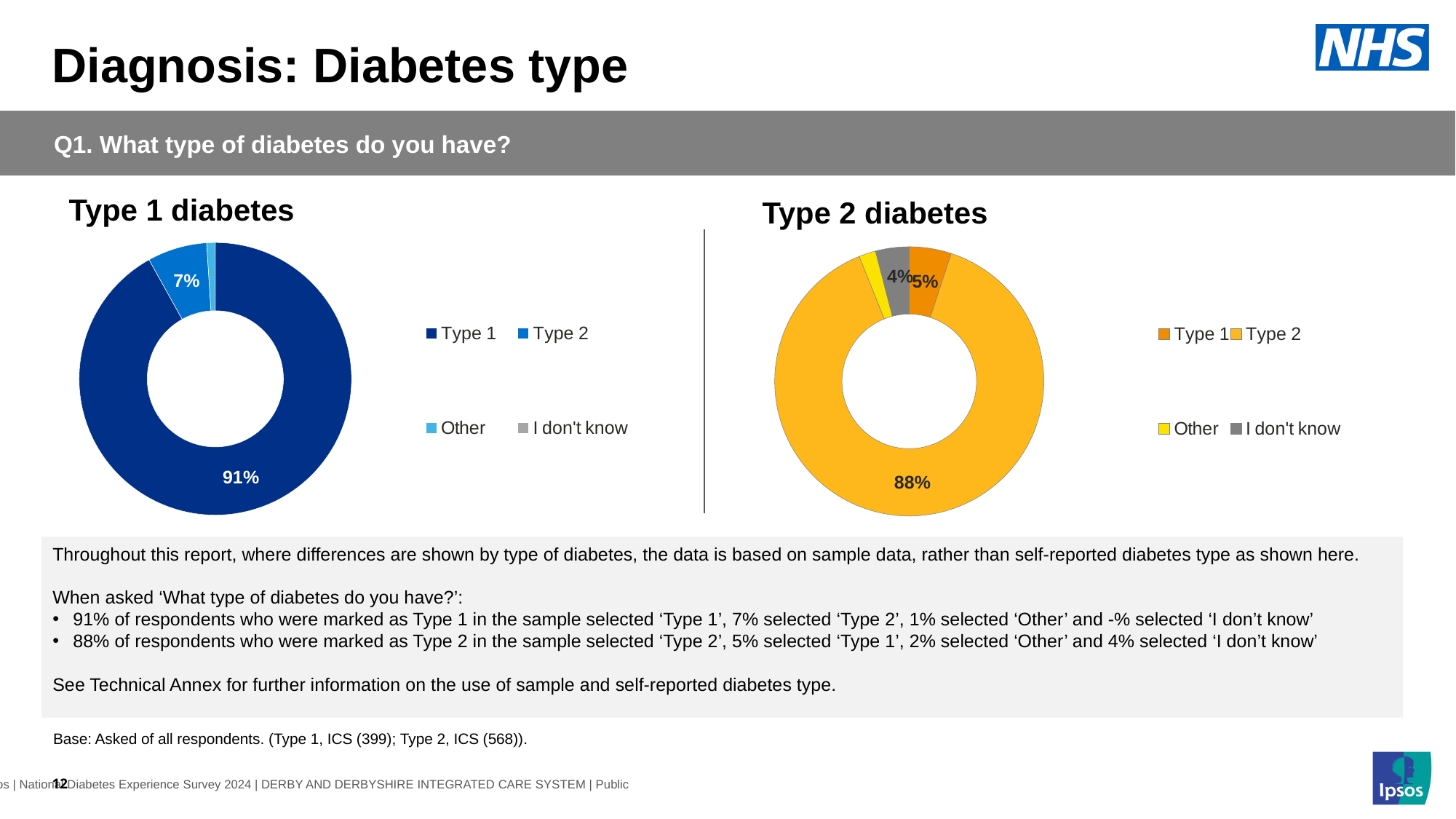
In the 'Type 1 diabetes' chart, which category has the largest share? Type 1 In the 'Type 2 diabetes' chart, what is the difference between the 'Type 2' and 'Type 1' shares? 83 percentage points In the 'Type 2 diabetes' chart, what percentage selected 'Type 1'? 5% Which is larger: the 'Type 1' share in the 'Type 1 diabetes' chart or the 'Type 2' share in the 'Type 2 diabetes' chart? Type 1 share in the Type 1 diabetes chart In the 'Type 1 diabetes' chart, what percentage selected 'Type 2'? 7% How many categories does the legend of the 'Type 2 diabetes' chart list? 4 In the 'Type 1 diabetes' chart, what is the difference between the 'Type 1' and 'Type 2' shares? 84 percentage points In the 'Type 2 diabetes' chart, what percentage selected 'I don't know'? 4% In the 'Type 2 diabetes' chart, which category has the largest share? Type 2 What kind of chart is used for 'Type 1 diabetes'? Doughnut (pie) chart In the 'Type 1 diabetes' chart, what percentage selected 'Type 1'? 91% In the 'Type 2 diabetes' chart, what percentage selected 'Type 2'? 88%